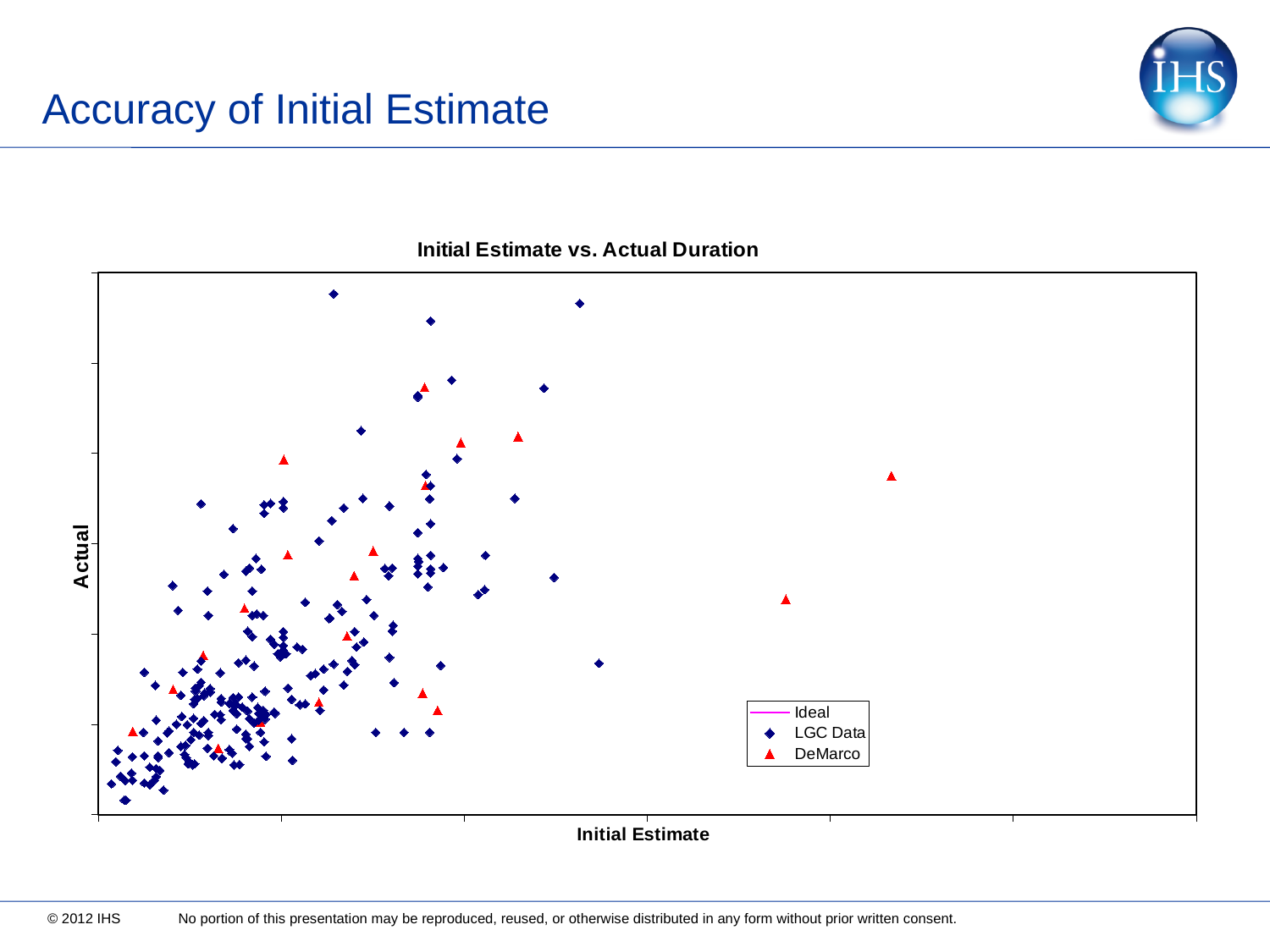
Do the Actual values generally rise or fall as the Initial Estimate increases along the x axis? Rise What kind of chart is shown on the slide? Scatter chart Which series contains the highest point on the chart? LGC Data How many series does the legend list? 3 Which series contains the point that lies furthest to the right on the chart? DeMarco Which series are listed in the chart legend? Ideal, LGC Data, DeMarco What is the title of the chart? Initial Estimate vs. Actual Duration